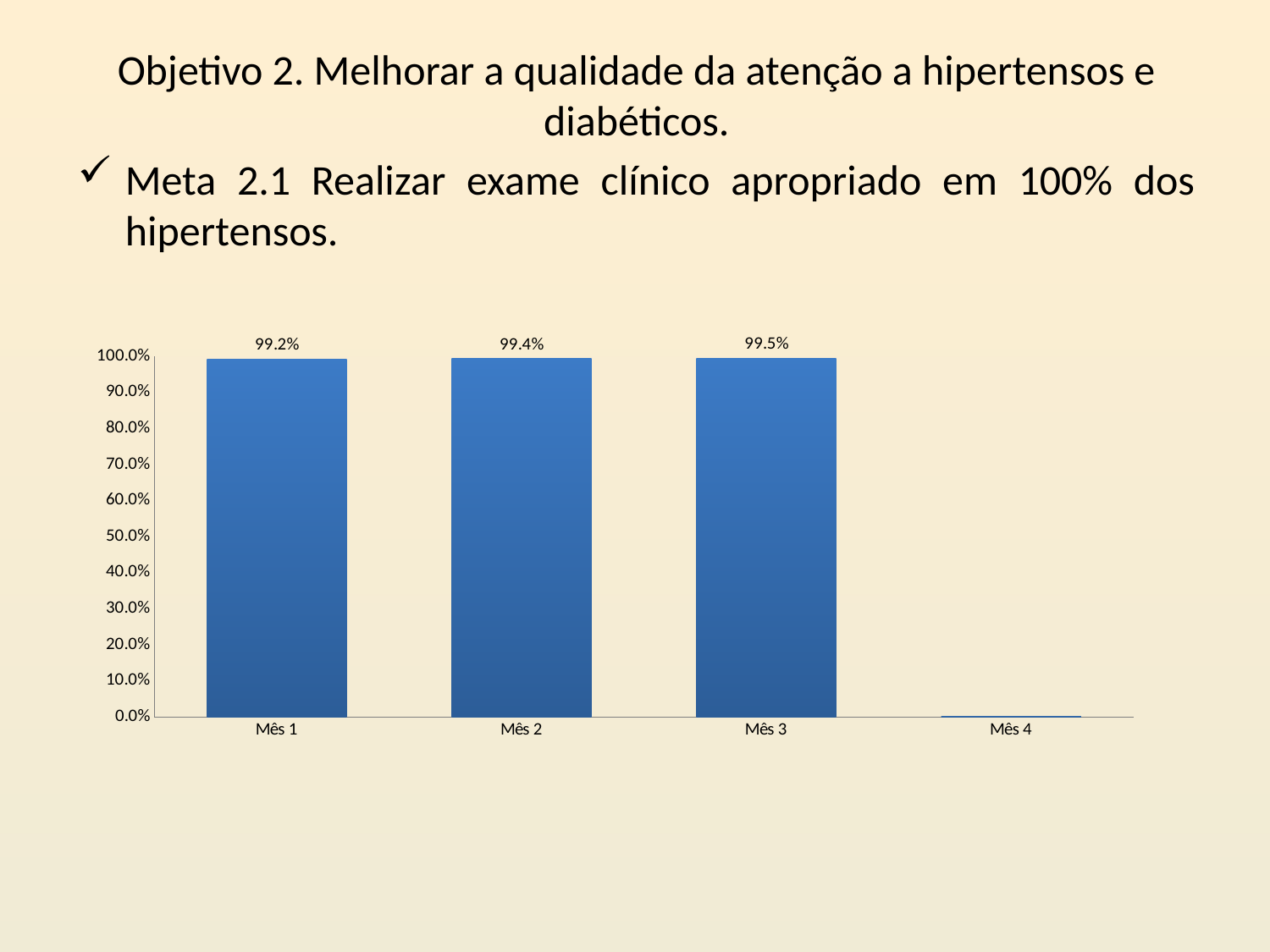
From Mês 1 to Mês 3, do the values rise or fall? rise Which is larger, the value for Mês 2 or the value for Mês 1? Mês 2 What colour are the bars in the chart? blue What is the difference between the values for Mês 3 and Mês 1? 0.3% Which month has the lowest value? Mês 4 What is the value for Mês 1? 99.2% How many months are shown on the x axis? 4 Which month has the highest value? Mês 3 What kind of chart is shown on the slide? bar chart Is the value for Mês 4 greater or less than 10.0%? less What is the value for Mês 2? 99.4% What is the value for Mês 3? 99.5%